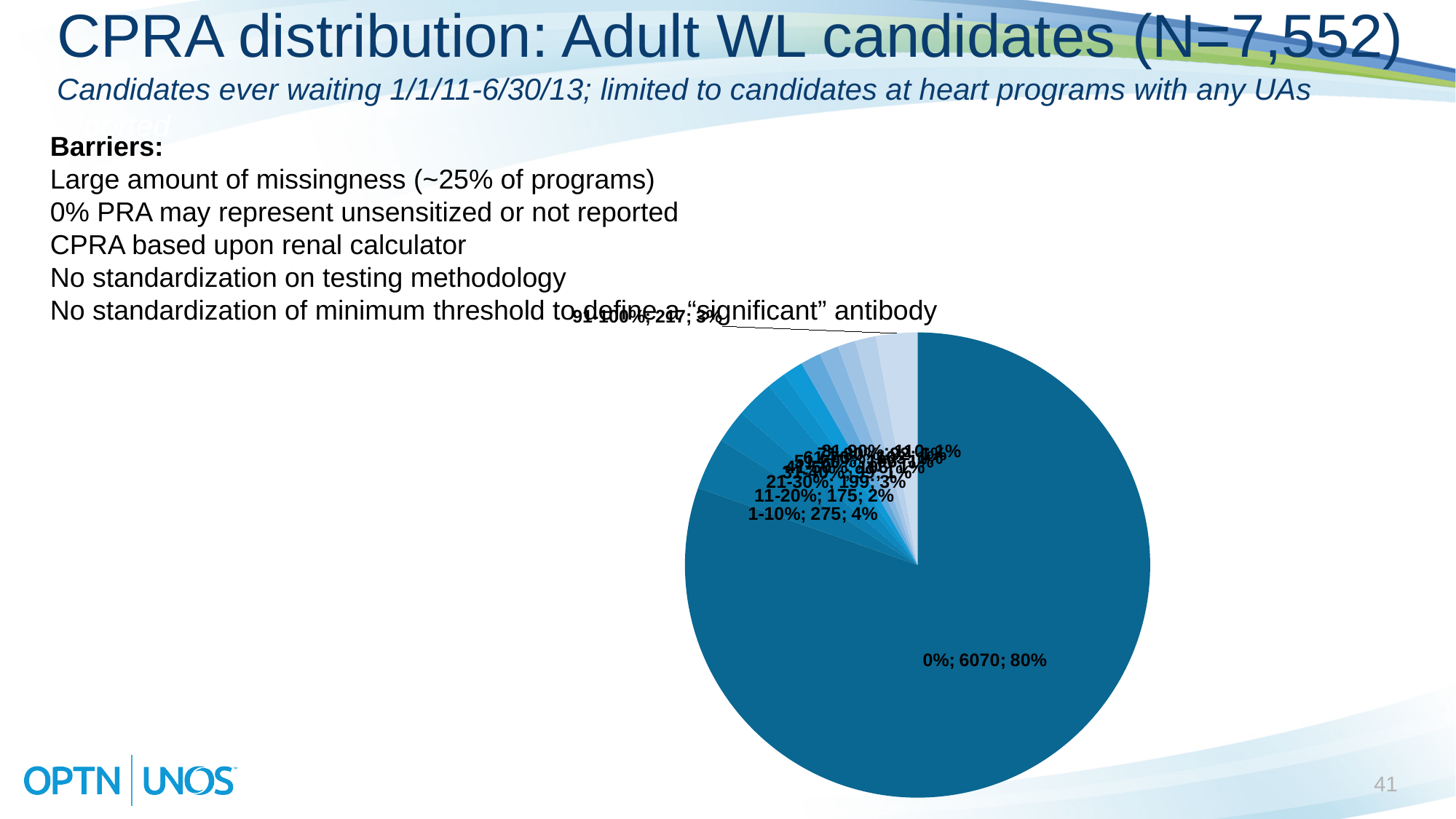
What is the difference in candidate counts between the 1-10% slice and the 11-20% slice? 100 How many candidates are in the 21-30% CPRA slice? 199 What is the total N of adult WL candidates stated in the chart's slide title? 7,552 How many candidates are in the 1-10% CPRA slice? 275 How many candidates are in the 11-20% CPRA slice? 175 What percentage of the pie is the 1-10% CPRA slice? 4% How many candidates are in the 0% CPRA slice of the pie chart? 6070 Which slice is larger, 1-10% or 11-20%? 1-10% What share of the pie does the 0% CPRA slice represent? 80% Which CPRA category has the largest slice of the pie? 0% What kind of chart is shown on the slide? pie chart What percentage of the pie is the 21-30% CPRA slice? 3%